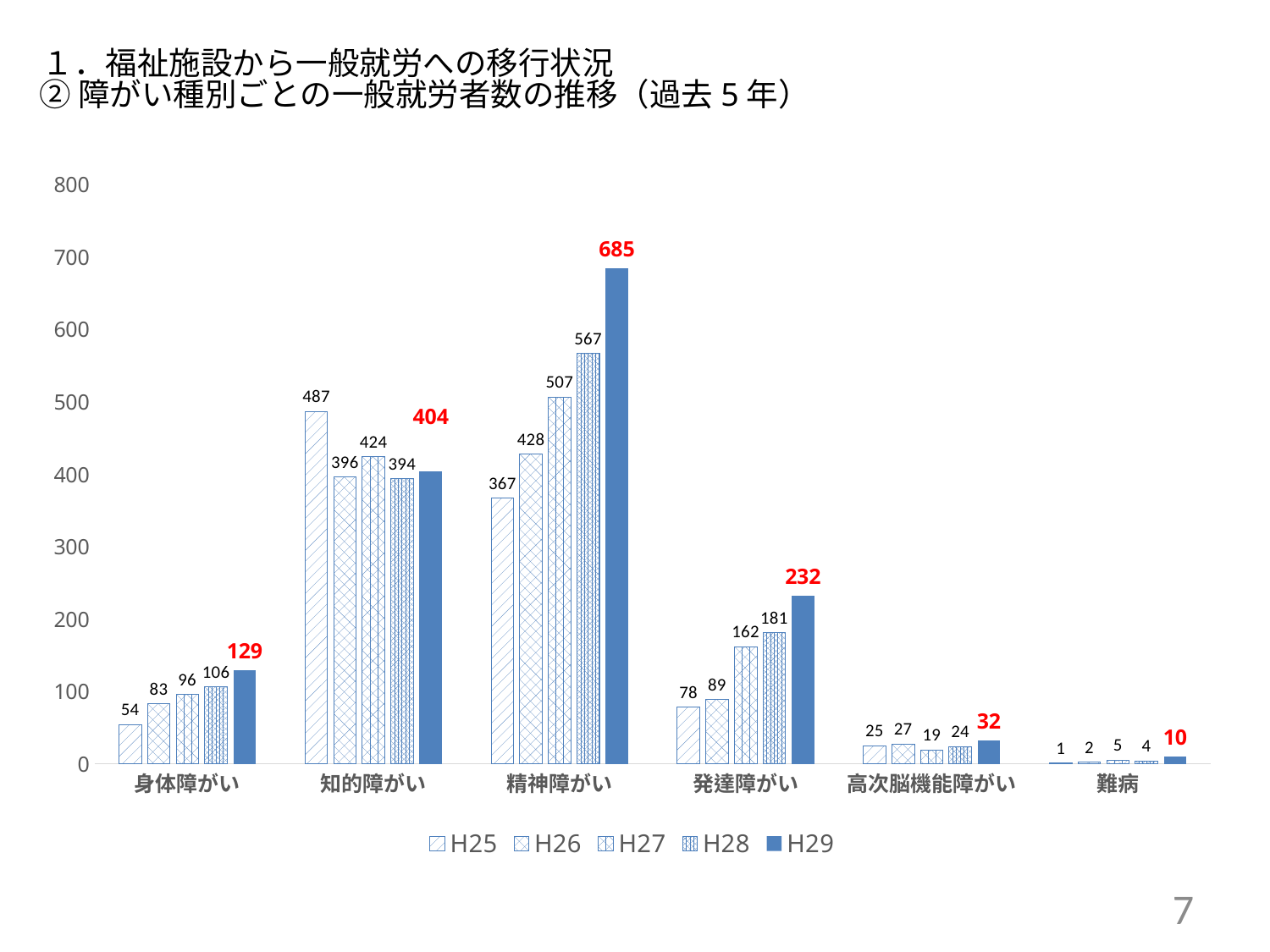
Which is larger for 知的障がい: the H25 value or the H29 value? H25 What is the difference between the H29 and H28 values for 精神障がい? 118 Which category has the lowest H25 value? 難病 What kind of chart is shown on the slide? bar chart What is the difference between the H29 values for 発達障がい and 身体障がい? 103 What is the H29 value for 精神障がい? 685 Which category has the highest H29 value? 精神障がい What is the H25 value for 知的障がい? 487 How many series does the legend list? 5 Do the values for 発達障がい rise or fall from H25 to H29? rise What is the H27 value for 発達障がい? 162 How many categories are shown on the x axis? 6